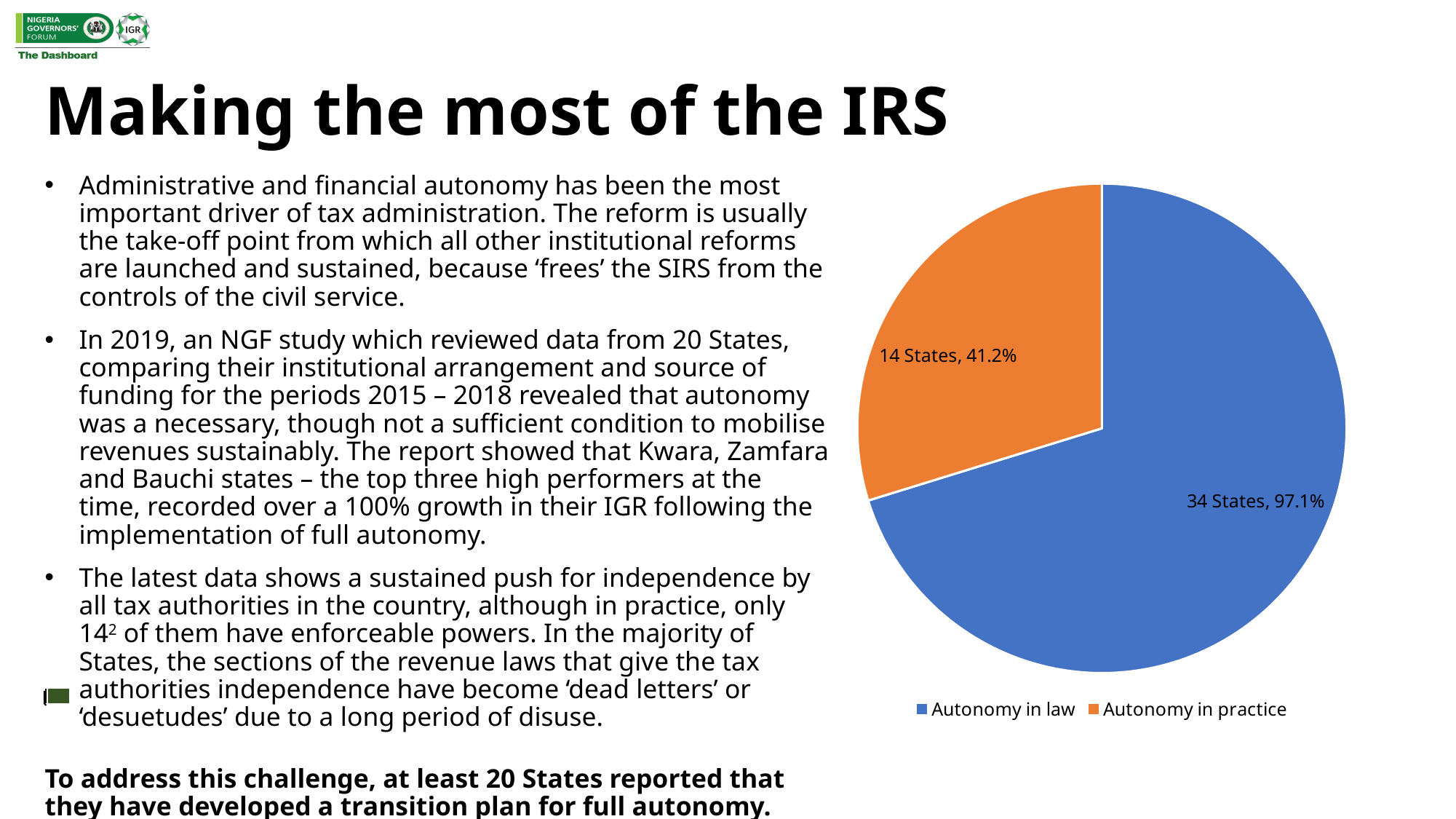
How many more states have Autonomy in law than Autonomy in practice according to the pie chart? 20 States How many slices does the pie chart have? 2 What percentage is printed on the Autonomy in practice slice? 41.2% What colour is the Autonomy in practice slice in the pie chart? Orange What percentage is printed on the Autonomy in law slice? 97.1% How many states are shown for Autonomy in practice in the pie chart? 14 States Which slice of the pie chart is the largest? Autonomy in law How many entries does the legend of the pie chart list? 2 What kind of chart is shown on the slide? Pie chart Which has more states in the pie chart, Autonomy in law or Autonomy in practice? Autonomy in law Which slice of the pie chart is the smallest? Autonomy in practice How many states are shown for Autonomy in law in the pie chart? 34 States